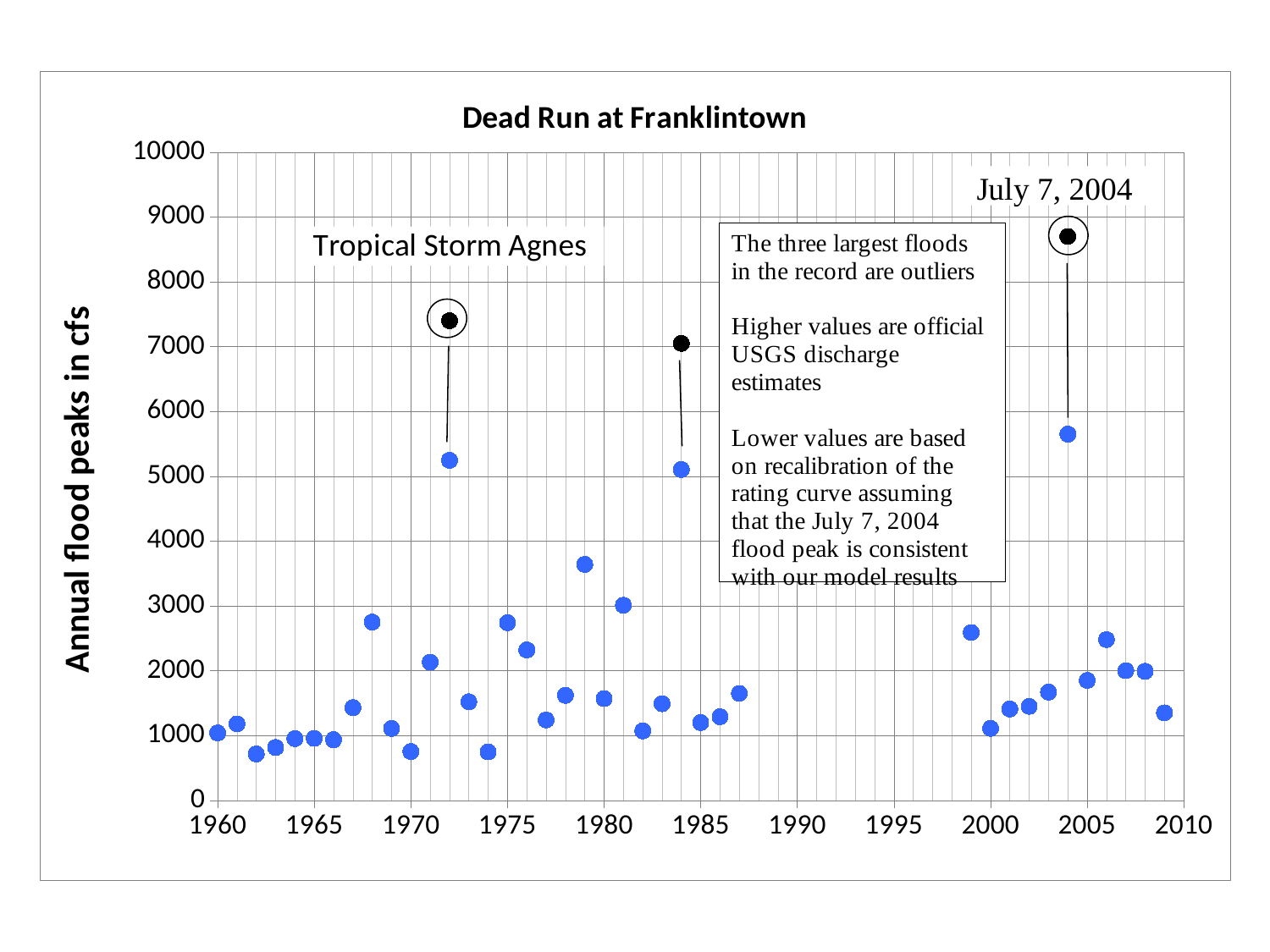
Is the official USGS flood peak value for July 7, 2004 greater or less than 8000? greater Is the recalibrated (lower) flood peak value for 1984 greater or less than 6000? less What is the title of the chart? Dead Run at Franklintown Is the flood peak value for 1979 greater or less than 3000? greater Which year has the highest annual flood peak in the chart? 2004 Which storm is labeled at the 1972 flood peak? Tropical Storm Agnes Which is larger, the official USGS flood peak for 1972 or the official USGS flood peak for 1984? 1972 Which is larger, the flood peak for 1979 or the flood peak for 1981? 1979 What kind of chart is shown on the slide? Scatter chart